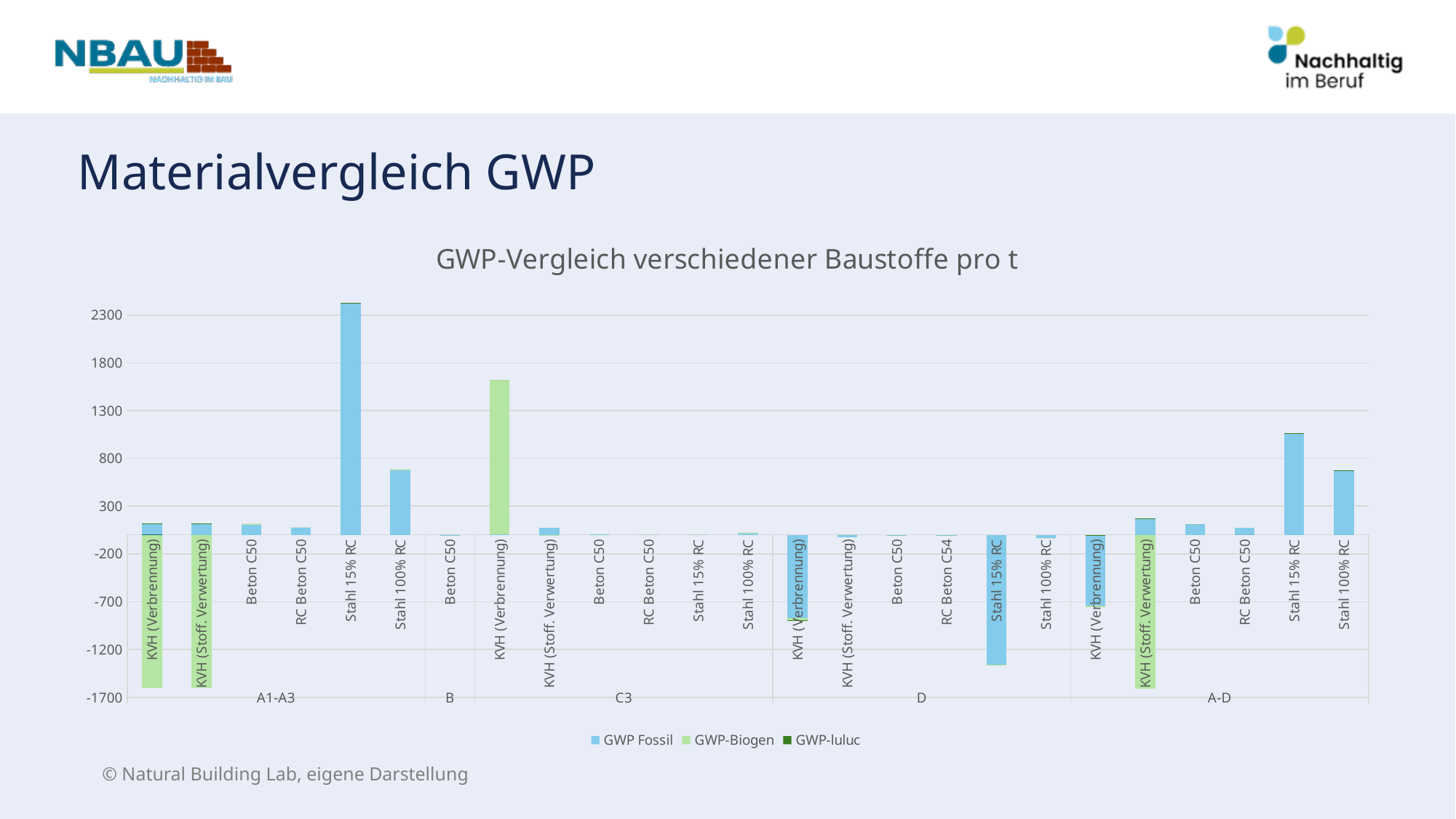
How many series does the legend list? 3 How many life-cycle stage groups are shown along the x axis? 5 Is the value for Stahl 15% RC in the D group greater or less than -1200? less Is the value for Stahl 15% RC in the A1-A3 group greater or less than 1800? greater In the A1-A3 group, which is larger: the value for Stahl 15% RC or Stahl 100% RC? Stahl 15% RC What kind of chart is shown on the slide? bar chart Is the value for Stahl 100% RC in the A1-A3 group greater or less than 800? less What is the title of the chart? GWP-Vergleich verschiedener Baustoffe pro t Which series is shown in blue in the legend? GWP Fossil In the A-D group, which is larger: the value for Stahl 15% RC or Stahl 100% RC? Stahl 15% RC Which bar reaches the highest positive value in the chart? Stahl 15% RC (A1-A3)